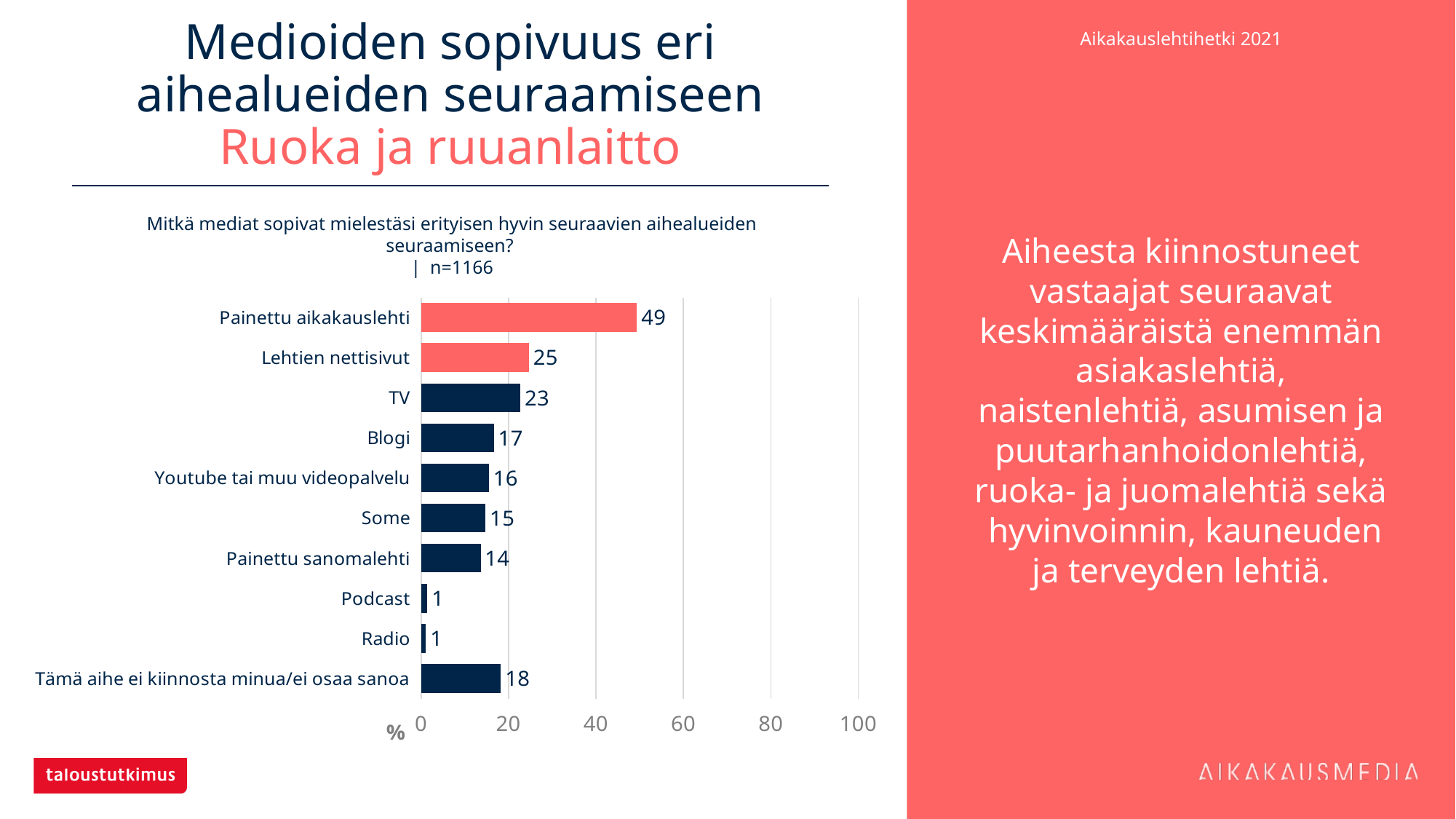
What is the value for Painettu aikakauslehti? 49 What is the value for Youtube tai muu videopalvelu? 16 Which category has the highest value? Painettu aikakauslehti How many categories are shown in the chart? 10 Which is larger, the value for TV or the value for Blogi? TV Is the value for Painettu aikakauslehti greater or less than 40? greater What is the value for Tämä aihe ei kiinnosta minua/ei osaa sanoa? 18 What kind of chart is shown on the slide? Bar chart What is the sample size (n) stated above the chart? n=1166 What is the difference between the values for Some and Painettu sanomalehti? 1 What is the value for Lehtien nettisivut? 25 What is the difference between the values for Painettu aikakauslehti and Lehtien nettisivut? 24